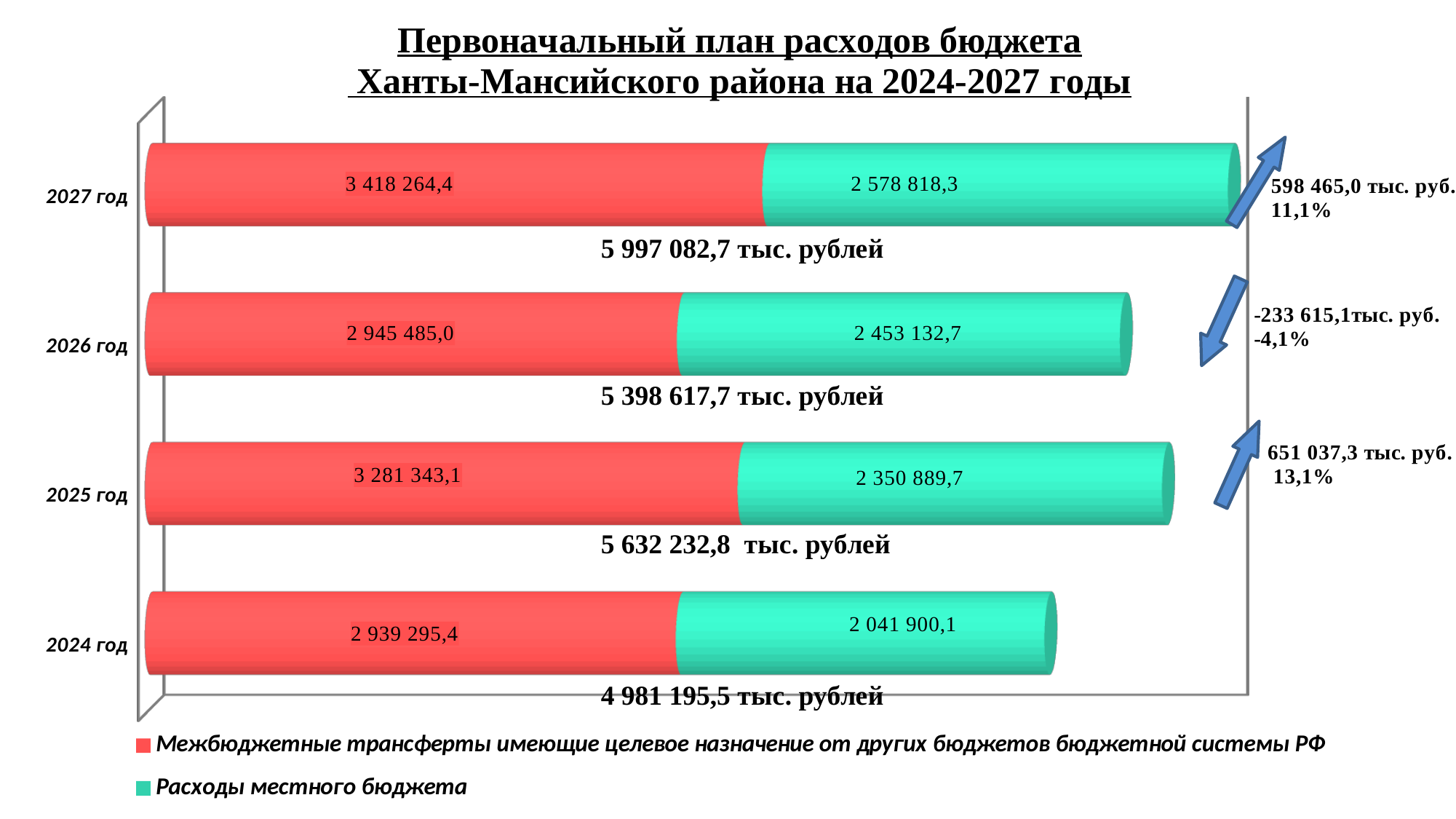
In 2025 год, which is larger: «Межбюджетные трансферты...» or «Расходы местного бюджета»? Межбюджетные трансферты имеющие целевое назначение от других бюджетов бюджетной системы РФ What is the difference between the total for 2027 год and the total for 2026 год? 598 465,0 тыс. руб. How many years (categories) are shown in the chart? 4 In 2024 год, what is the difference between «Межбюджетные трансферты...» and «Расходы местного бюджета»? 897 395,3 What is the value of «Расходы местного бюджета» for 2026 год? 2 453 132,7 What is the value of «Межбюджетные трансферты имеющие целевое назначение от других бюджетов бюджетной системы РФ» for 2027 год? 3 418 264,4 What is the value of «Расходы местного бюджета» for 2024 год? 2 041 900,1 What is the total of the stacked bar for 2025 год? 5 632 232,8 тыс. рублей What kind of chart is shown on the slide? Stacked bar chart Which year has the lowest value for «Расходы местного бюджета»? 2024 год Which year has the highest value for «Расходы местного бюджета»? 2027 год How many series does the legend list? 2